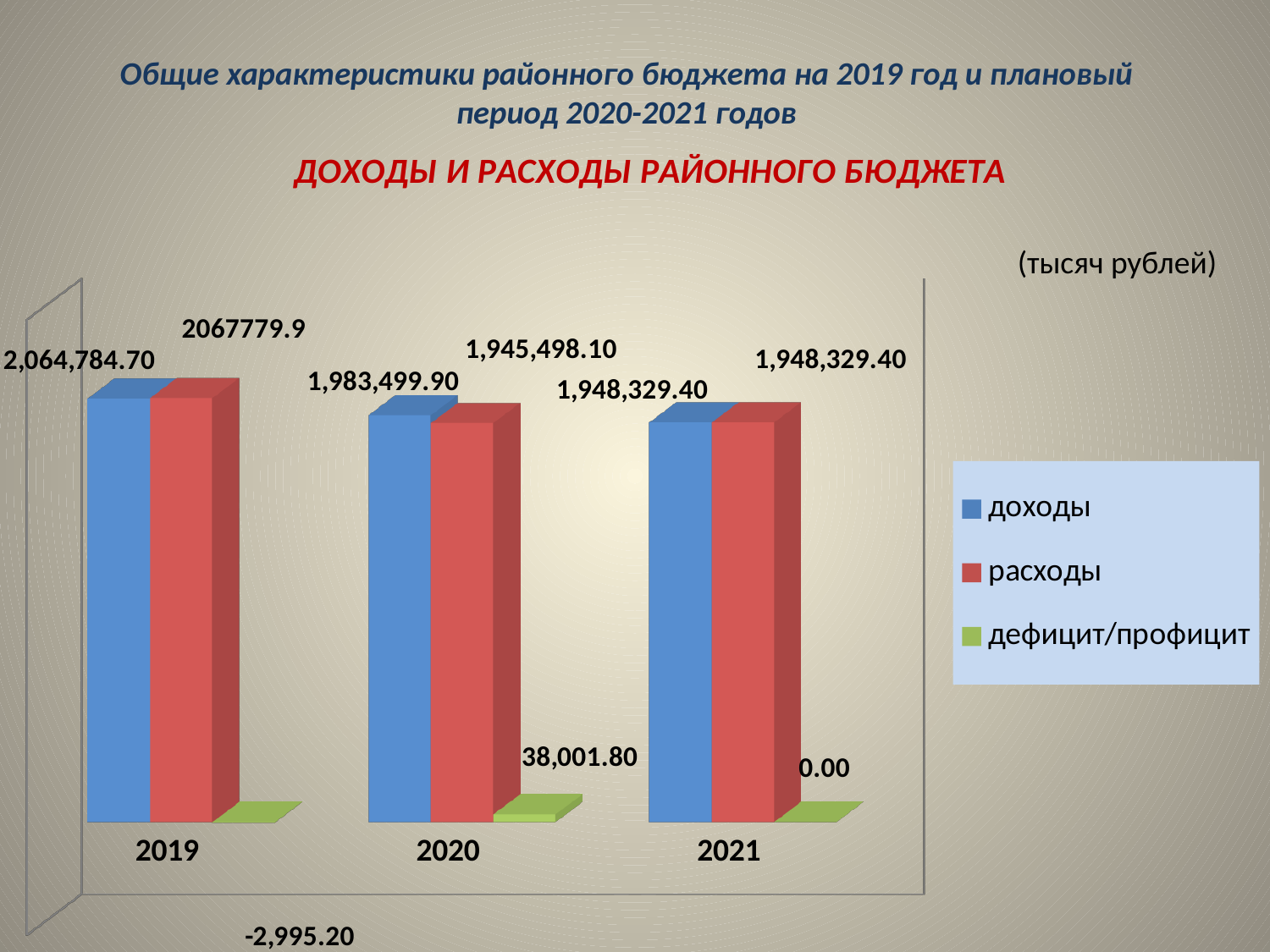
What is the value of дефицит/профицит for 2019? -2,995.20 In which year is доходы the highest? 2019 What is the value of дефицит/профицит for 2020? 38,001.80 What kind of chart is shown on the slide? bar chart How many years are shown on the x axis? 3 How many series does the legend list? 3 In which year is доходы the lowest? 2021 What is the value of доходы for 2019? 2,064,784.70 In 2020, which is larger: доходы or расходы? доходы What is the difference between доходы and расходы in 2020? 38,001.80 What is the value of дефицит/профицит for 2021? 0.00 What is the value of расходы for 2020? 1,945,498.10